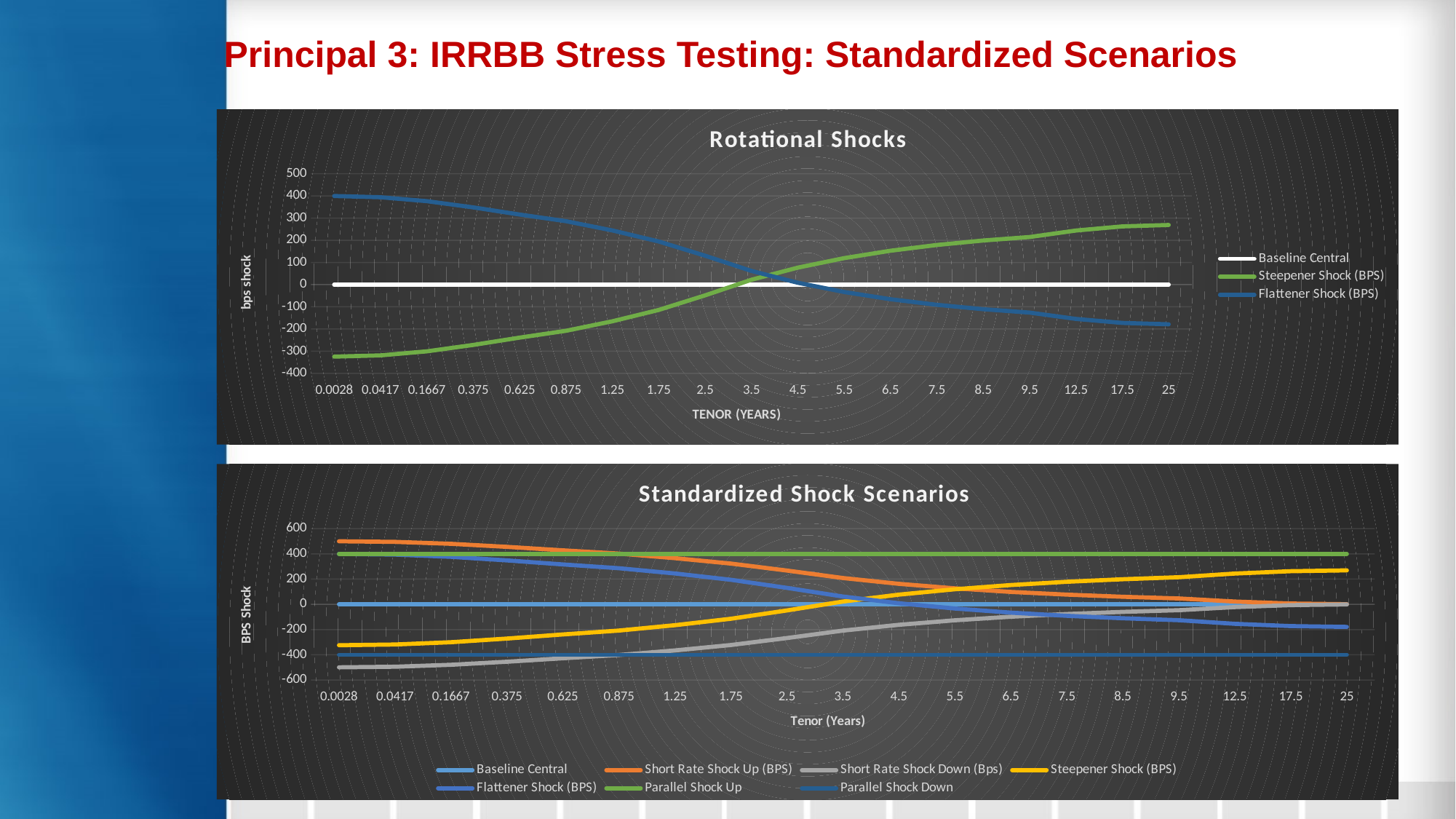
How many tenor points are shown on the x axis of the 'Rotational Shocks' chart? 19 What is the y-axis title of the 'Rotational Shocks' chart? bps shock How many series does the legend of the 'Standardized Shock Scenarios' chart list? 7 In the 'Rotational Shocks' chart, at tenor 25, which is larger: Steepener Shock (BPS) or Flattener Shock (BPS)? Steepener Shock (BPS) In the 'Rotational Shocks' chart, is the Steepener Shock (BPS) value at tenor 25 greater or less than 200? greater In the 'Rotational Shocks' chart, does the Flattener Shock (BPS) line rise or fall as tenor increases? falls What kind of chart is the 'Rotational Shocks' chart? line chart In the 'Standardized Shock Scenarios' chart, which series has the lowest value at tenor 0.0028? Short Rate Shock Down (Bps) In the 'Rotational Shocks' chart, what is the value of Baseline Central across all tenors? 0 In the 'Rotational Shocks' chart, does the Steepener Shock (BPS) line rise or fall as tenor increases? rises How many series does the legend of the 'Rotational Shocks' chart list? 3 In the 'Standardized Shock Scenarios' chart, what is the value of Parallel Shock Up across all tenors? 400